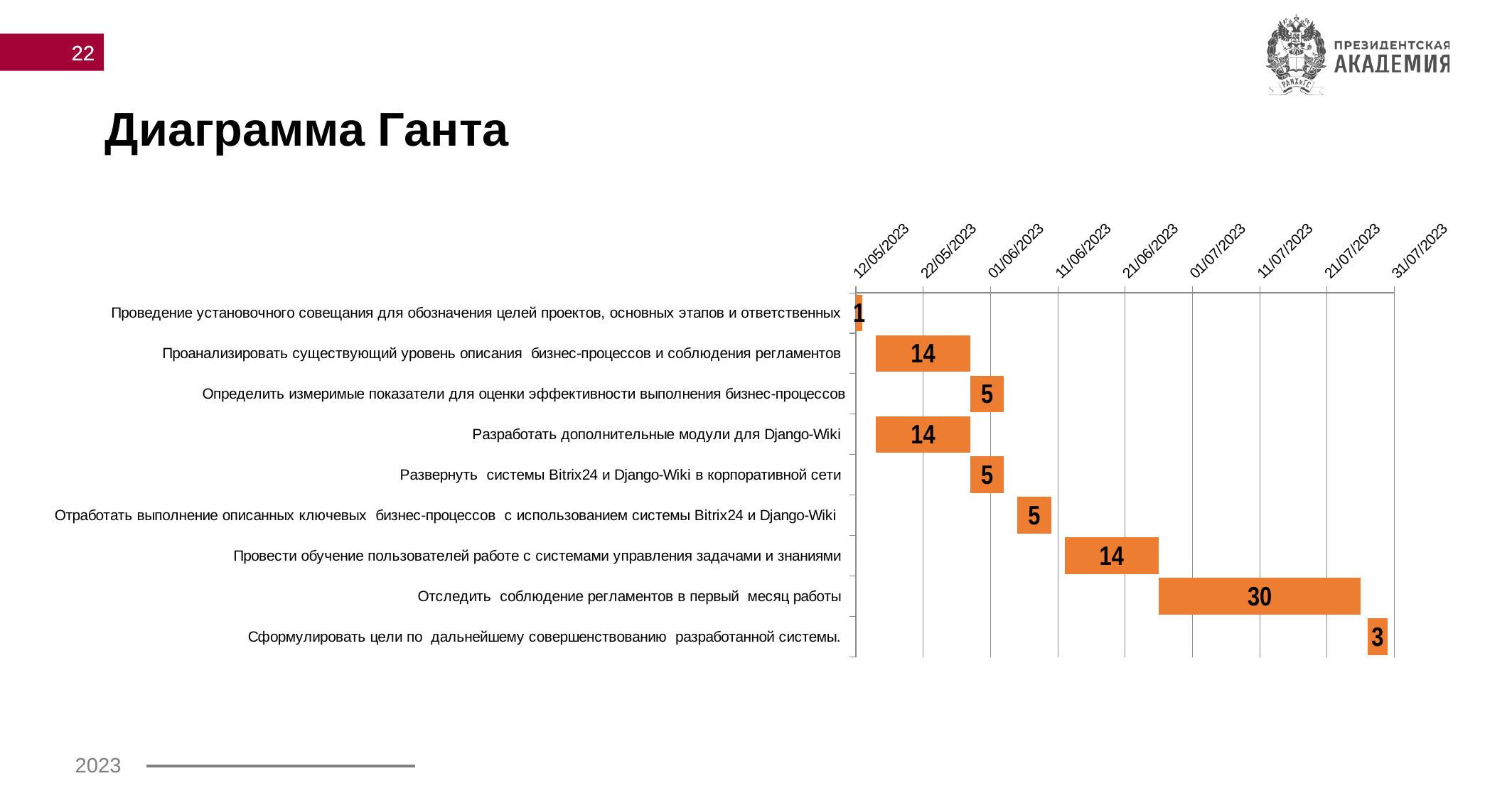
What is the title of the slide containing the chart? Диаграмма Ганта What value is printed on the bar for 'Сформулировать цели по дальнейшему совершенствованию разработанной системы.'? 3 What is the difference between the value for 'Отследить соблюдение регламентов в первый месяц работы' and the value for 'Провести обучение пользователей работе с системами управления задачами и знаниями'? 16 Which task has the largest value on its bar? Отследить соблюдение регламентов в первый месяц работы What colour are the bars in the chart? Orange What kind of chart is shown on the slide? Bar chart (Gantt chart) Which has the larger value: 'Разработать дополнительные модули для Django-Wiki' or 'Определить измеримые показатели для оценки эффективности выполнения бизнес-процессов'? Разработать дополнительные модули для Django-Wiki How many tasks are listed on the chart? 9 What is the duration value shown for the task 'Отследить соблюдение регламентов в первый месяц работы'? 30 What is the value shown on the bar for 'Проанализировать существующий уровень описания бизнес-процессов и соблюдения регламентов'? 14 What value is shown for 'Развернуть системы Bitrix24 и Django-Wiki в корпоративной сети'? 5 Which task has the smallest value on its bar? Проведение установочного совещания для обозначения целей проектов, основных этапов и ответственных